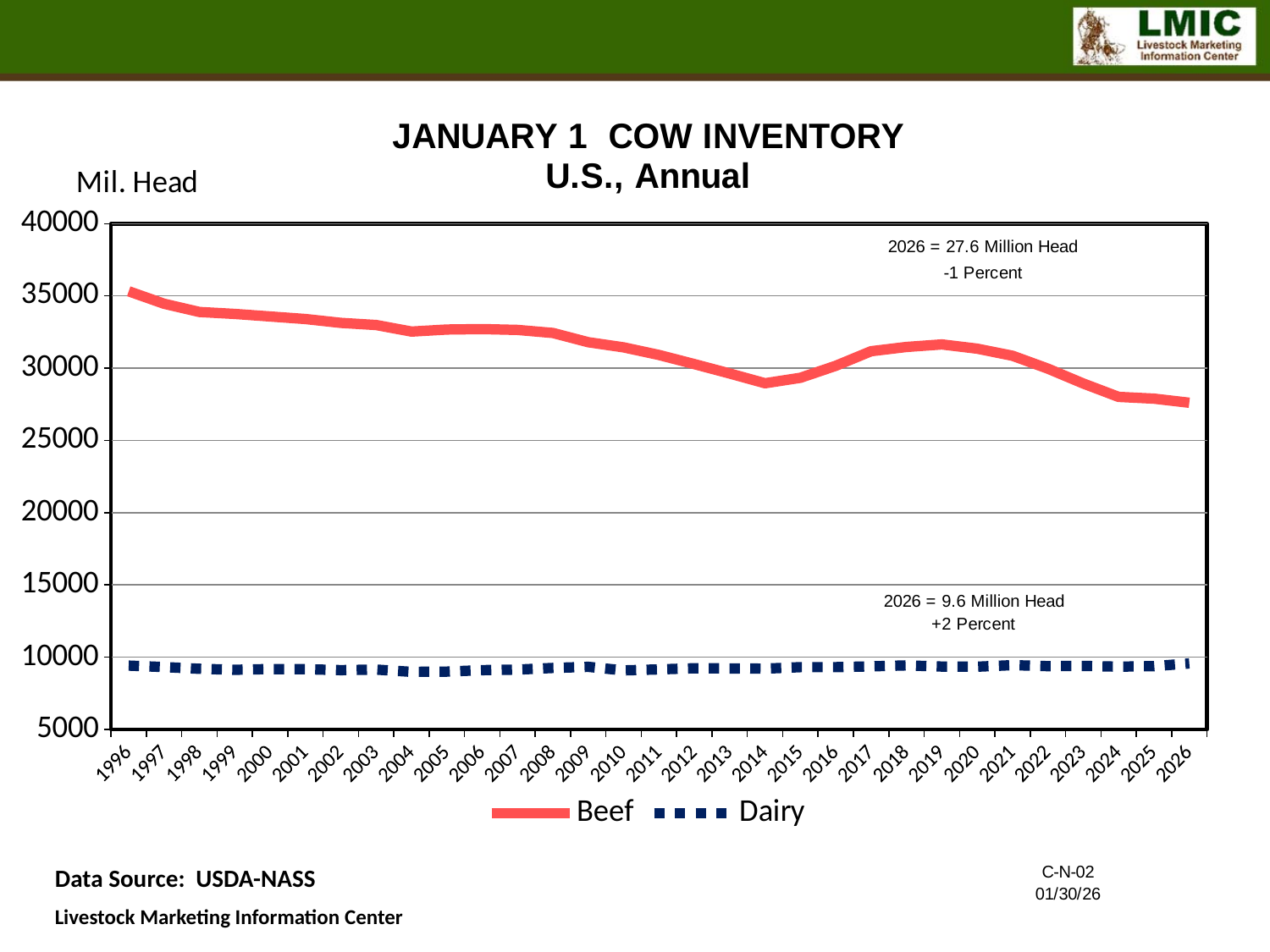
How many series does the legend list? 2 What type of chart is shown on the slide? Line chart According to the annotation, what is the Beef cow inventory for 2026? 27.6 Million Head In which year is the Beef series at its highest? 1996 What are the two series shown in the legend? Beef and Dairy What is the difference between the 2026 Beef and Dairy inventories shown in the annotations? 18 Million Head According to the annotation, what is the Dairy cow inventory for 2026? 9.6 Million Head Does the Beef series generally rise or fall from 1996 to 2026? Fall Which series is larger in 2026, Beef or Dairy? Beef What percent change is noted for the Dairy series in 2026? +2 Percent Is the Beef value for 2014 greater or less than 30000? less What percent change is noted for the Beef series in 2026? -1 Percent